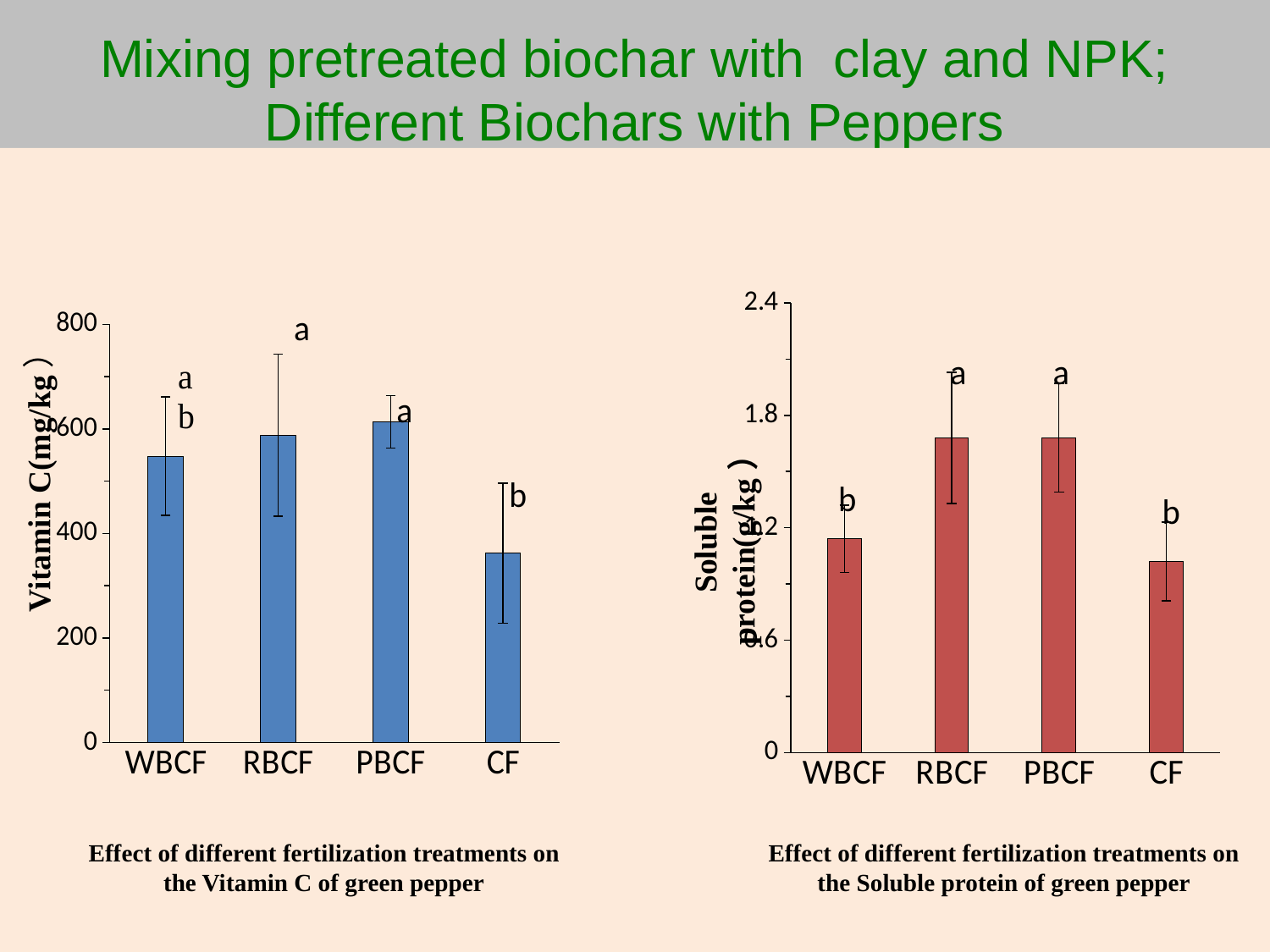
What kind of chart is the Soluble protein chart (right)? bar chart On the Vitamin C chart (left), which treatment has the lowest Vitamin C value? CF On the Soluble protein chart (right), is the value for CF greater or less than 1.2? less On the Vitamin C chart (left), is the value for WBCF greater or less than 400? greater On the Soluble protein chart (right), is the value for PBCF greater or less than 1.8? less How many treatment categories are shown on the Vitamin C chart (left)? 4 On the Vitamin C chart (left), which is larger, the value for PBCF or the value for CF? PBCF On the Soluble protein chart (right), which treatment has the lowest soluble protein value? CF On the Soluble protein chart (right), which is larger, the value for RBCF or the value for CF? RBCF What is the y-axis title of the Vitamin C chart (left)? Vitamin C(mg/kg)